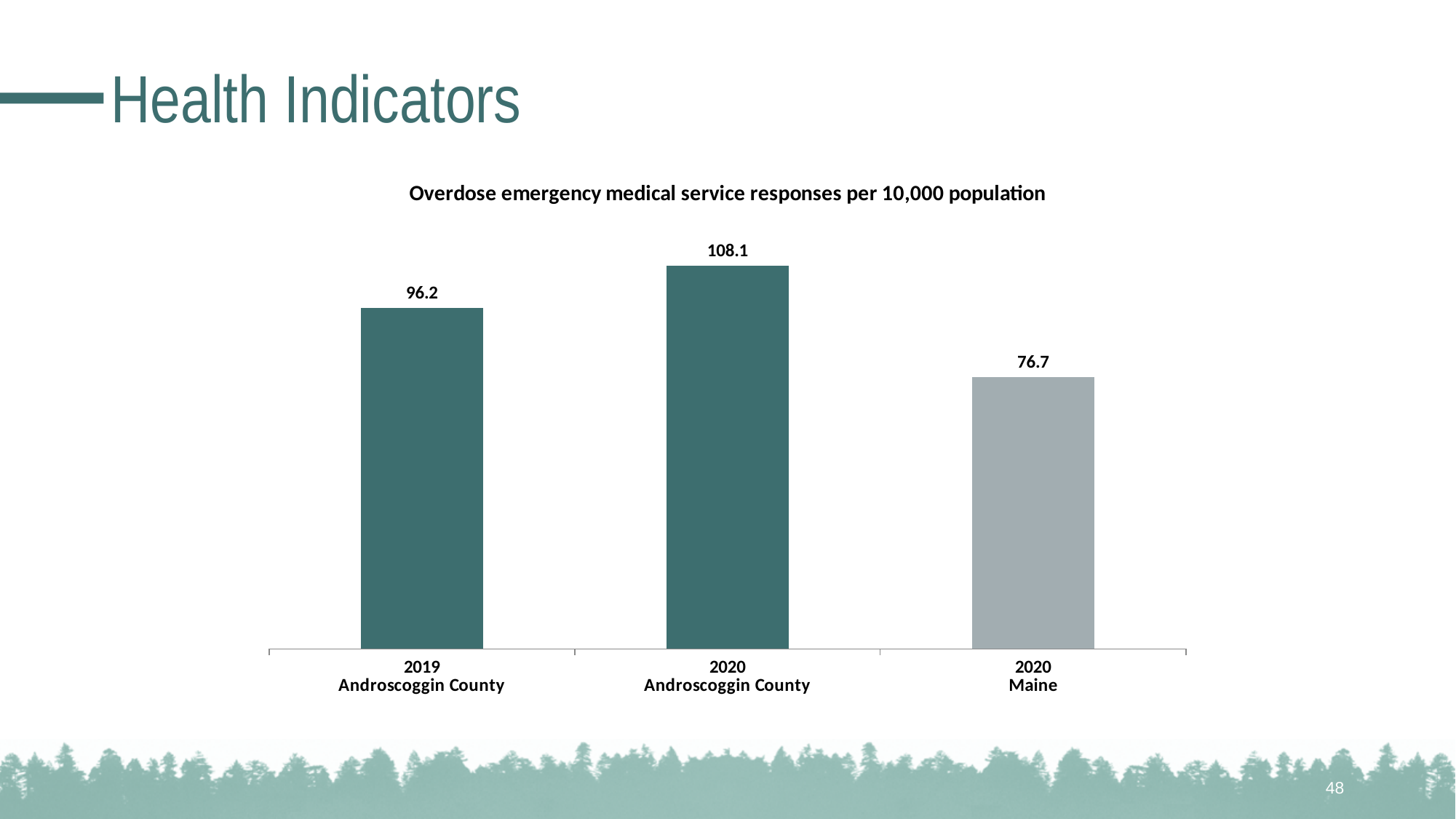
What is the difference between the 2020 Androscoggin County value and the 2020 Maine value? 31.4 What is the value for 2020 Maine? 76.7 Did the value for Androscoggin County rise or fall from 2019 to 2020? Rise How many bars are shown in the chart? 3 What kind of chart is shown on the slide? Bar chart Which is larger, the value for 2019 Androscoggin County or the value for 2020 Maine? 2019 Androscoggin County What is the difference between the 2020 Androscoggin County value and the 2019 Androscoggin County value? 11.9 What is the value for 2020 Androscoggin County? 108.1 Which category has the lowest value? 2020 Maine Which category has the highest value? 2020 Androscoggin County What is the value for 2019 Androscoggin County? 96.2 What is the title of the chart? Overdose emergency medical service responses per 10,000 population